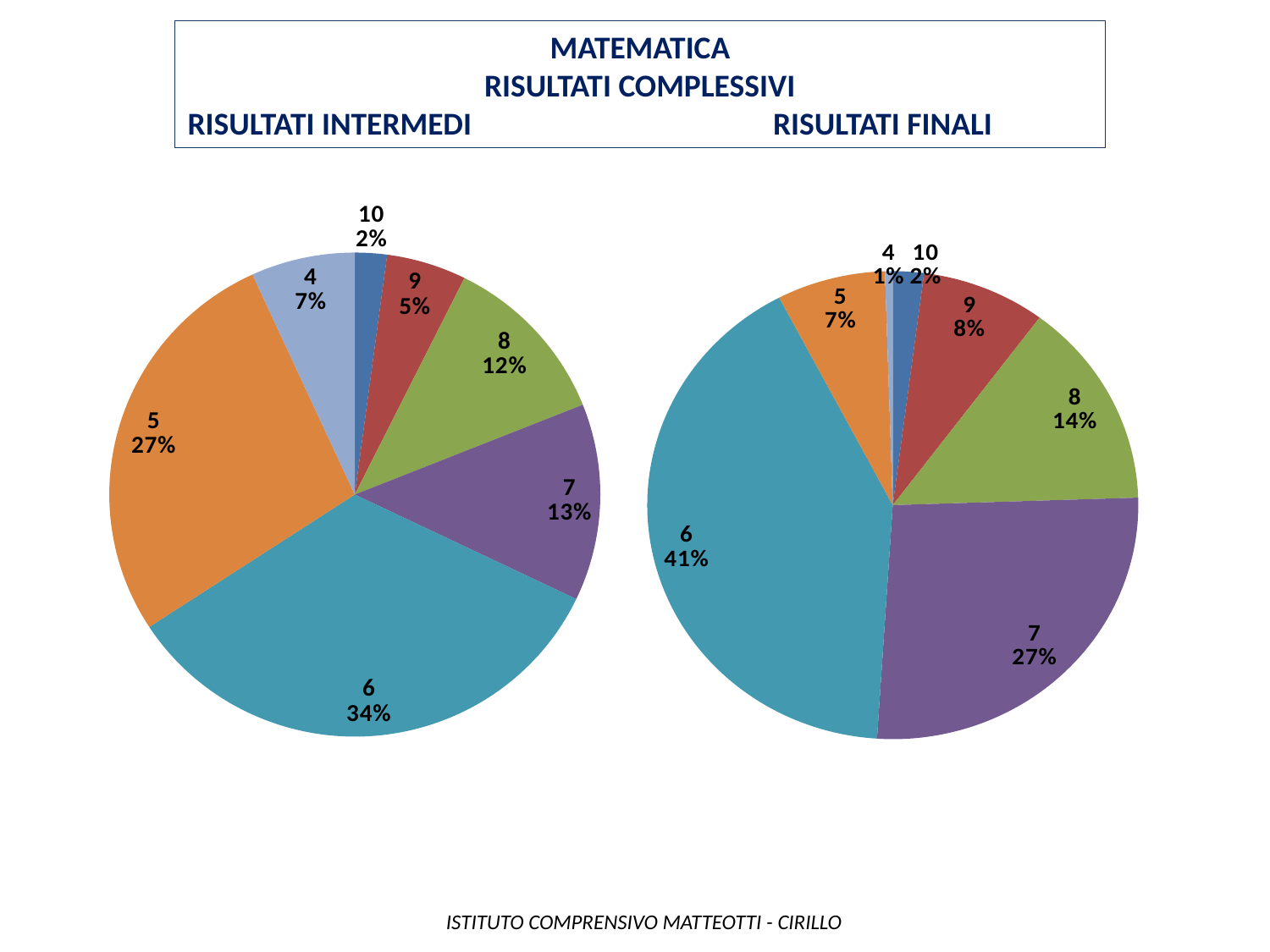
In the RISULTATI INTERMEDI pie chart, which is larger: the share of grade 8 or the share of grade 7? 7 How many slices does the RISULTATI FINALI pie chart have? 7 In the RISULTATI FINALI pie chart, which grade has the smallest slice? 4 In the RISULTATI INTERMEDI pie chart, what share does grade 6 have? 34% In the RISULTATI INTERMEDI pie chart, what percentage is shown for grade 5? 27% In the RISULTATI INTERMEDI pie chart, which grade has the smallest slice? 10 In the RISULTATI FINALI pie chart, what share does grade 7 have? 27% In the RISULTATI FINALI pie chart, what percentage is shown for grade 8? 14% In the RISULTATI FINALI pie chart, what is the difference between the shares of grade 6 and grade 7? 14% In the RISULTATI INTERMEDI pie chart, what is the difference between the shares of grade 6 and grade 5? 7% In the RISULTATI FINALI pie chart, which grade has the largest slice? 6 What type of chart is used for RISULTATI INTERMEDI? Pie chart